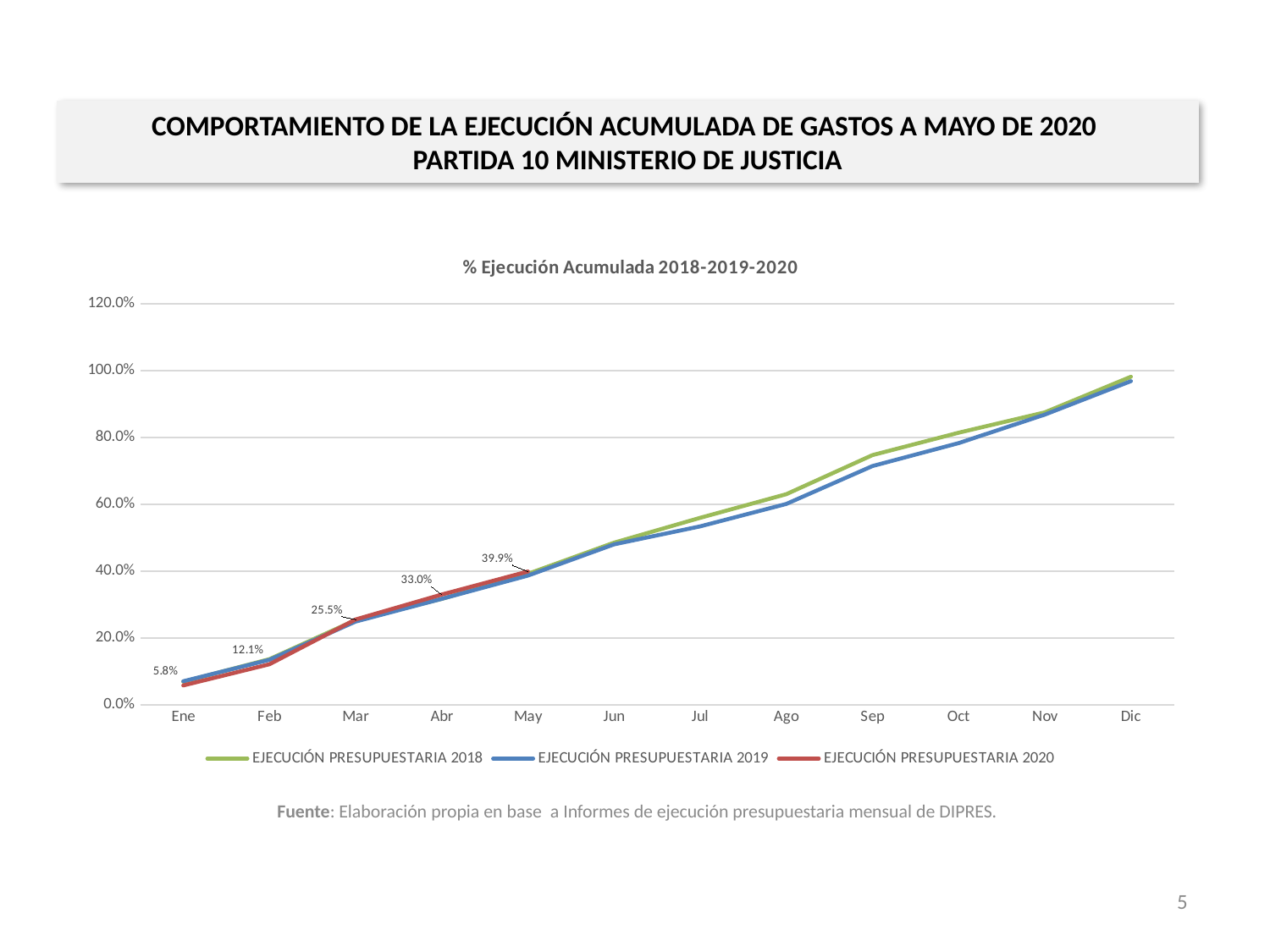
By how many percentage points did EJECUCIÓN PRESUPUESTARIA 2020 increase from Ene to May? 34.1 percentage points What is the value for EJECUCIÓN PRESUPUESTARIA 2020 in Mar? 25.5% What type of chart is shown on the slide? line chart In Sep, which series is higher: EJECUCIÓN PRESUPUESTARIA 2018 or EJECUCIÓN PRESUPUESTARIA 2019? EJECUCIÓN PRESUPUESTARIA 2018 What is the value for EJECUCIÓN PRESUPUESTARIA 2020 in May? 39.9% What is the title of the chart? % Ejecución Acumulada 2018-2019-2020 What is the value for EJECUCIÓN PRESUPUESTARIA 2020 in Feb? 12.1% What is the value for EJECUCIÓN PRESUPUESTARIA 2020 in Ene? 5.8% What is the value for EJECUCIÓN PRESUPUESTARIA 2020 in Abr? 33.0% How many months are shown on the x axis? 12 Is the value for EJECUCIÓN PRESUPUESTARIA 2019 in Sep greater or less than 80.0%? less How many series does the legend list? 3